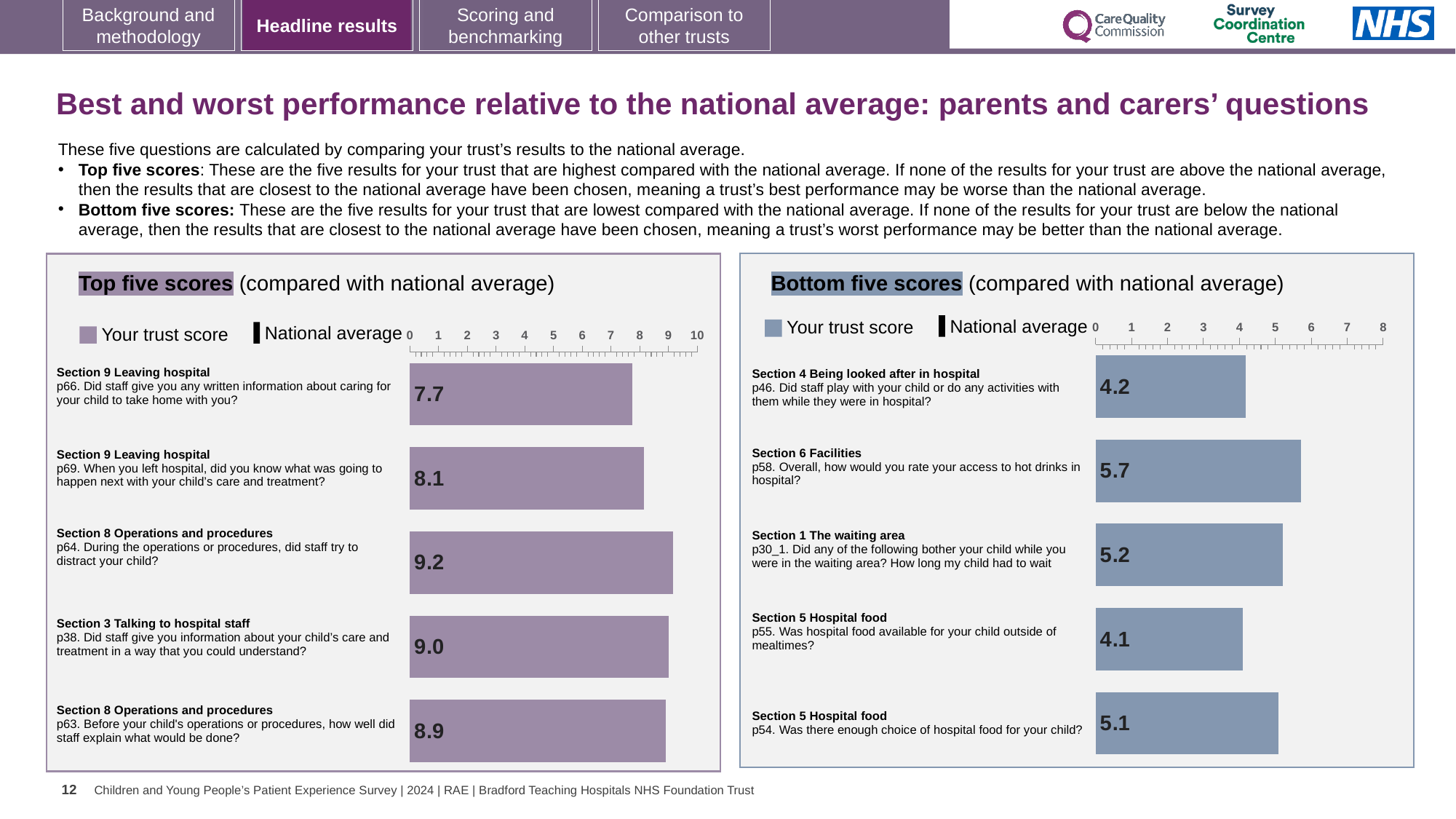
How many entries does the legend of the Bottom five scores chart list? 2 What kind of chart is the Top five scores chart? Bar chart In the Bottom five scores chart, is the trust score for p46 greater or less than 4? greater In the Top five scores chart, what is the difference between the trust scores for p69 and p66? 0.4 In the Bottom five scores chart, what is the trust score for p58 (Overall, how would you rate your access to hot drinks in hospital?)? 5.7 What is the highest value shown on the axis of the Top five scores chart? 10 In the Top five scores chart, which question has the highest trust score? p64. During the operations or procedures, did staff try to distract your child? In the Top five scores chart, what is the trust score for p64 (During the operations or procedures, did staff try to distract your child?)? 9.2 In the Bottom five scores chart, which has the larger trust score: p30_1 or p54? p30_1 In the Bottom five scores chart, what is the difference between the trust scores for p58 and p55? 1.6 How many questions are shown in the Top five scores chart? 5 In the Bottom five scores chart, which question has the lowest trust score? p55. Was hospital food available for your child outside of mealtimes?